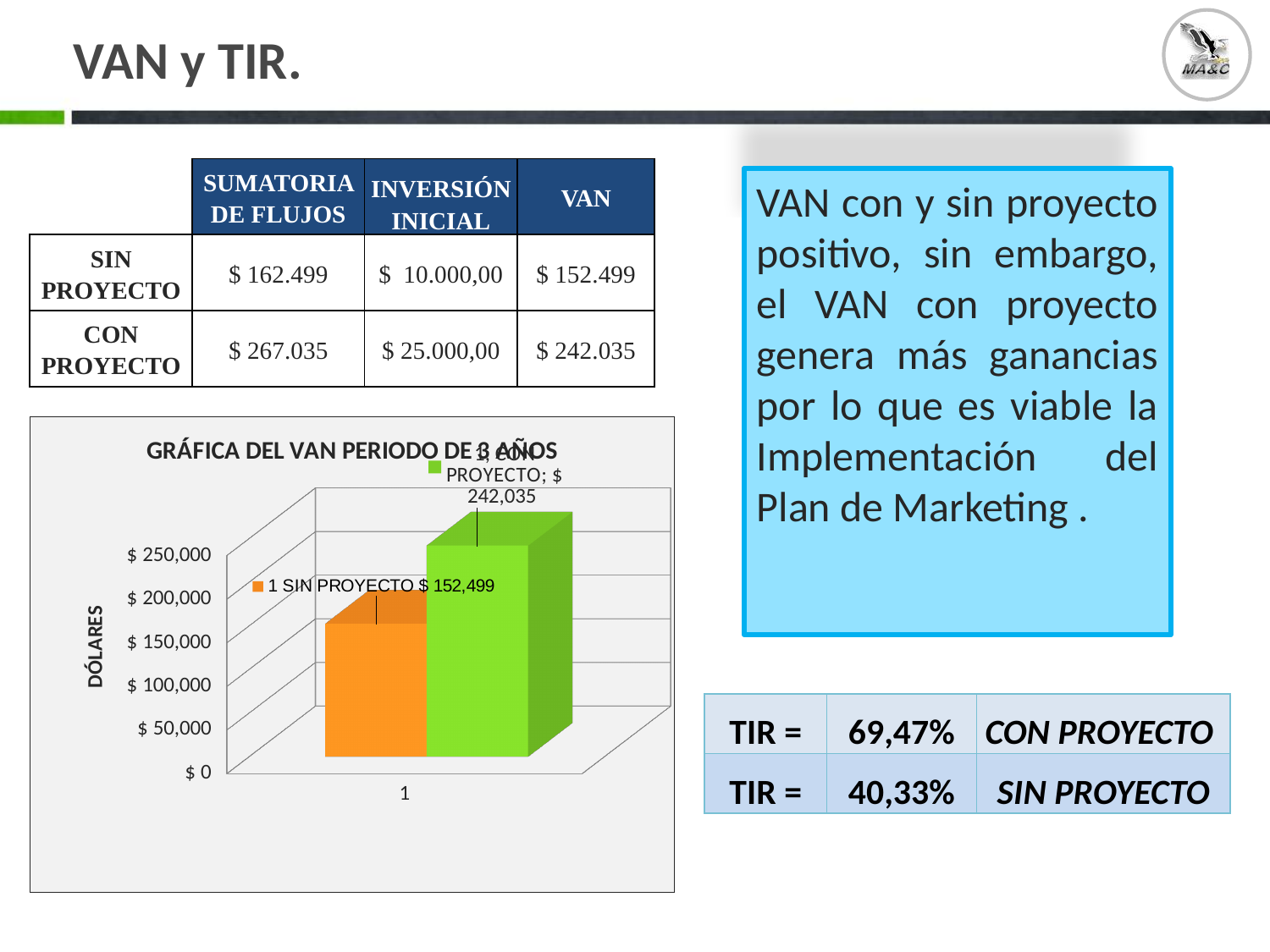
Is the value for SIN PROYECTO greater or less than $ 100,000? greater What is the difference between the CON PROYECTO and SIN PROYECTO values in the chart? $ 89,536 How many bars are plotted in the chart? 2 Is the value for CON PROYECTO greater or less than $ 200,000? greater What is the value shown for SIN PROYECTO in the chart? $ 152,499 Which bar in the chart is the highest? CON PROYECTO What is the value shown for CON PROYECTO in the chart? $ 242,035 Which is larger in the chart, SIN PROYECTO or CON PROYECTO? CON PROYECTO What kind of chart is shown on the slide? bar chart Which bar in the chart is the lowest? SIN PROYECTO What is the label of the vertical axis of the chart? DÓLARES What is the title of the chart? GRÁFICA DEL VAN PERIODO DE 3 AÑOS